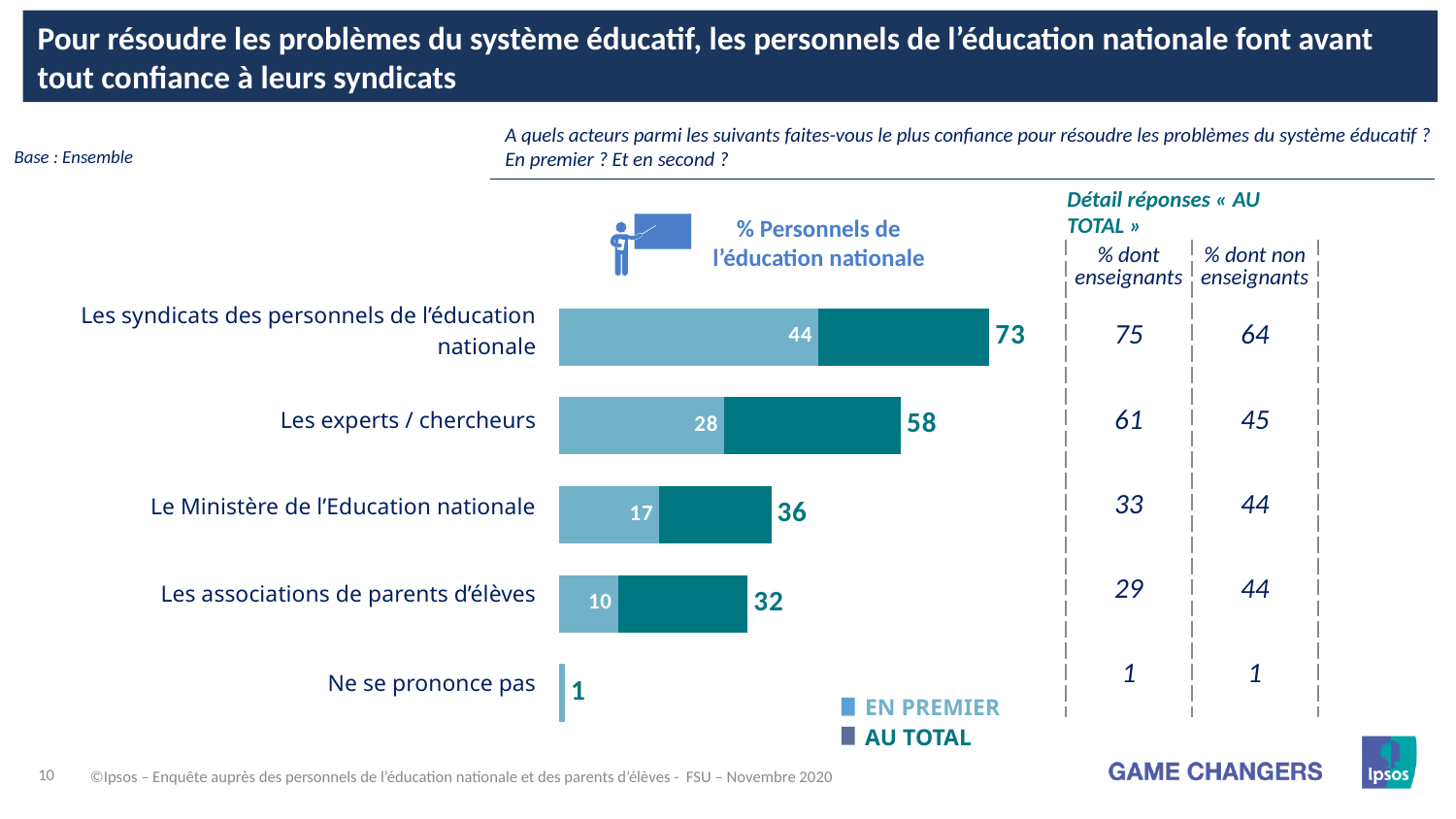
What kind of chart is shown on the slide? Bar chart What is the 'EN PREMIER' value for 'Les experts / chercheurs'? 28 What is the 'AU TOTAL' value for 'Le Ministère de l'Education nationale'? 36 What is the 'AU TOTAL' value for 'Les syndicats des personnels de l'éducation nationale'? 73 Which has a larger 'EN PREMIER' value: 'Le Ministère de l'Education nationale' or 'Les associations de parents d'élèves'? Le Ministère de l'Education nationale What is the difference between the 'AU TOTAL' and 'EN PREMIER' values for 'Les syndicats des personnels de l'éducation nationale'? 29 How many categories are shown in the bar chart? 5 How many series does the legend list? 2 What is the 'EN PREMIER' value for 'Les associations de parents d'élèves'? 10 What is the difference between the 'AU TOTAL' values for 'Les experts / chercheurs' and 'Le Ministère de l'Education nationale'? 22 Which category has the lowest 'AU TOTAL' value? Ne se prononce pas Which category has the highest 'AU TOTAL' value? Les syndicats des personnels de l'éducation nationale